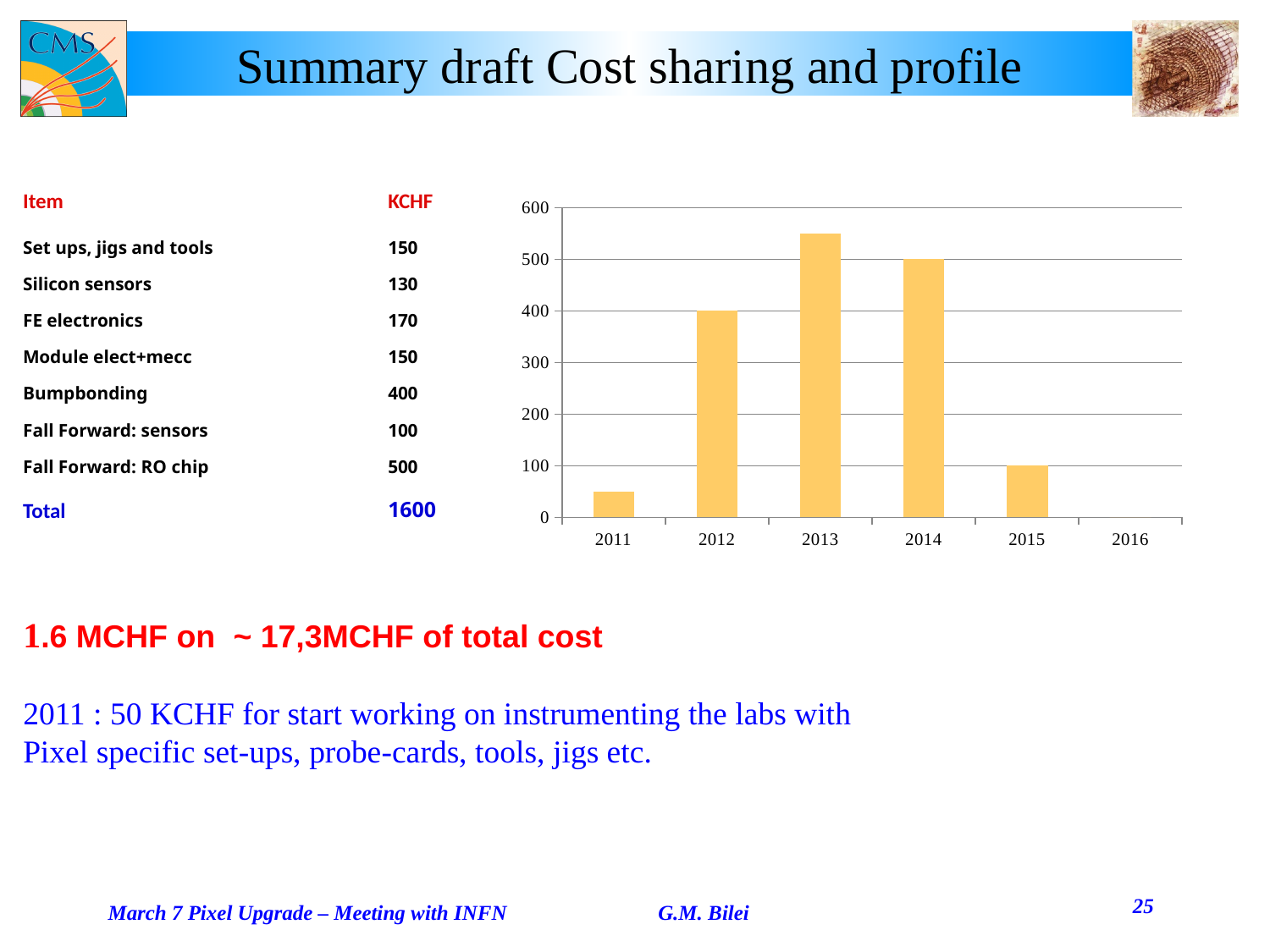
Do the bar values rise or fall from 2013 to 2015? fall What is the value of the bar for 2012? 400 What is the difference between the values for 2014 and 2012? 100 What kind of chart is shown on the slide? bar chart Which year has the highest bar in the chart? 2013 Which is larger, the bar for 2012 or the bar for 2014? 2014 Is the value for 2013 greater or less than 500? greater Is the value for 2011 greater or less than 100? less How many years are shown on the x axis of the chart? 6 Which year on the x axis has no visible bar? 2016 What is the value of the bar for 2015? 100 What is the value of the bar for 2014? 500